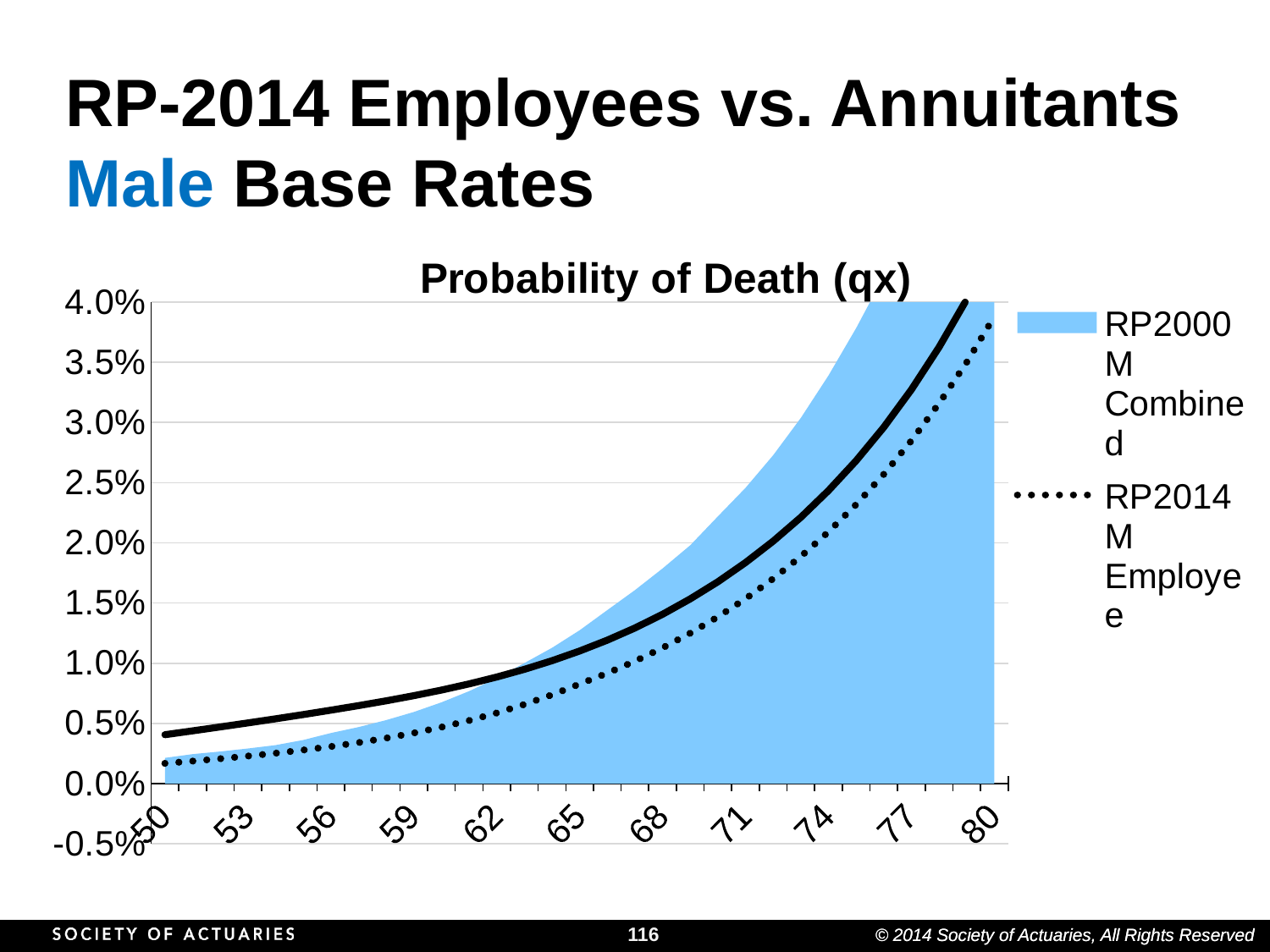
What is the title of the chart? Probability of Death (qx) What kind of chart is shown on the slide? Area and line chart What is the highest age label shown on the x axis? 80 At age 74, which is higher: RP2000 M Combined or RP2014 M Employee? RP2000 M Combined Which series is shown as a dotted line in the legend? RP2014 M Employee Is the value for RP2000 M Combined at age 74 greater or less than 2.5%? greater How many series does the chart legend list? 2 How many age labels are shown on the x axis? 11 Is the value for RP2014 M Employee at age 50 greater or less than 0.5%? less Is the value for RP2014 M Employee at age 65 greater or less than 1.0%? less Do the values for RP2014 M Employee rise or fall as age increases from 50 to 80? Rise